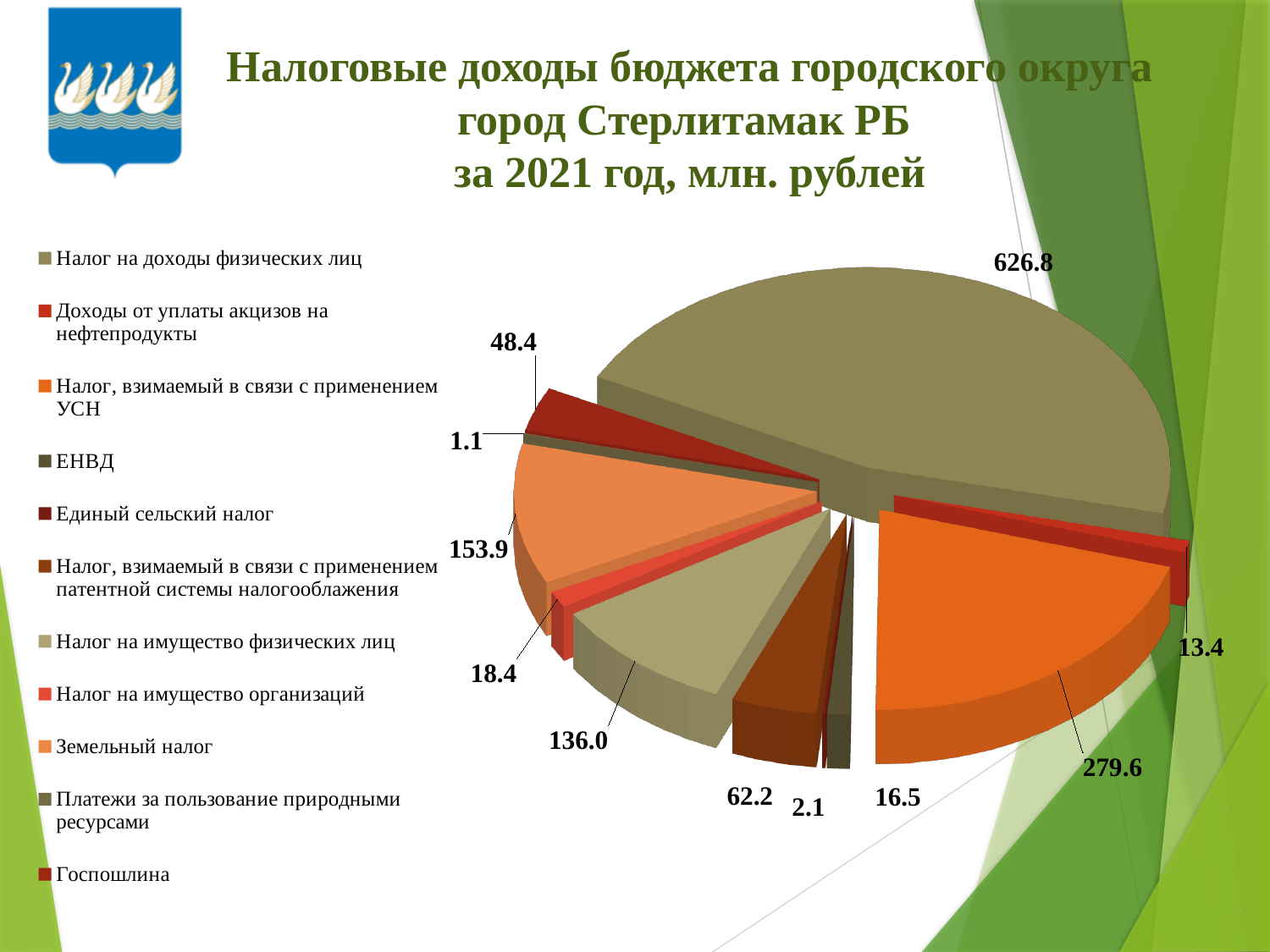
Which category has the largest slice of the pie chart? Налог на доходы физических лиц How many categories does the legend of the pie chart list? 11 What kind of chart is shown on the slide? Pie chart What is the value for Налог, взимаемый в связи с применением УСН? 279.6 What is the value of the largest slice of the pie chart? 626.8 Which is larger: the value for Земельный налог or the value for Налог на имущество физических лиц? Земельный налог What is the smallest value labelled on the pie chart? 1.1 What is the difference between the value for Налог на доходы физических лиц and the value for Налог, взимаемый в связи с применением УСН? 347.2 What is the value for Госпошлина? 48.4 What year does the chart title say the tax revenues are for? 2021 What is the value for Земельный налог? 153.9 What is the value for Налог на имущество физических лиц? 136.0